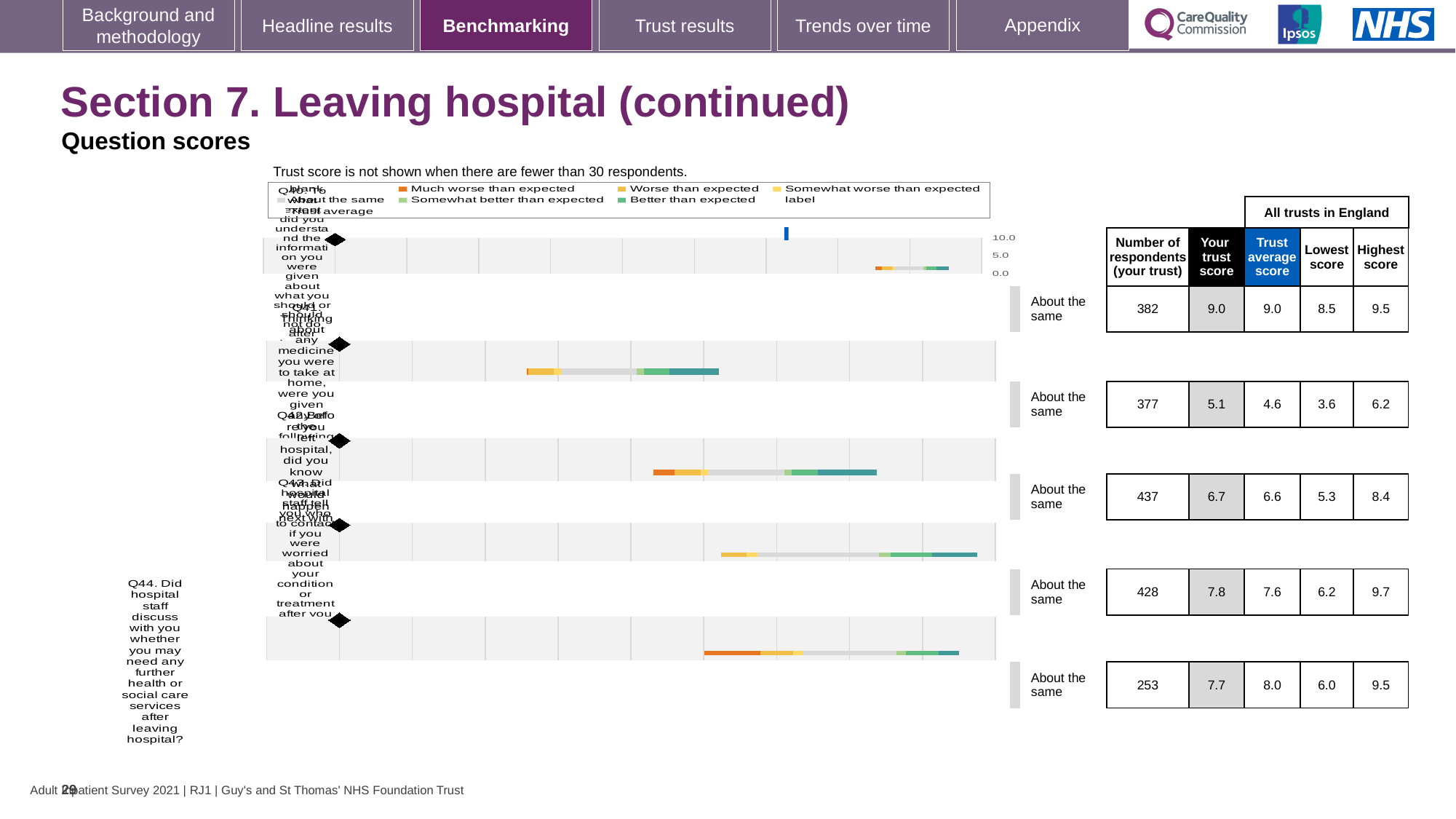
For Q44 (further health or social care services after leaving hospital), how many respondents does the table show for your trust? 253 What kind of chart is used to show the benchmarking results? Bar chart What is the trust average score for Q44 in the table? 8.0 What benchmark category label is shown next to every question row? About the same What is the lowest 'Your trust score' shown in the table? 5.1 How many question rows are shown in the benchmarking chart and table? 5 Which row of the table has the largest number of respondents? 437 (third question row) For Q44, which is larger: your trust score or the trust average score? Trust average score (8.0) For Q44, what is the difference between the highest score and the lowest score across all trusts in England? 3.5 What is the 'Your trust score' for Q44 in the table? 7.7 What is the lowest score across all trusts in England for the first question row (382 respondents)? 8.5 What is the highest score across all trusts in England for Q44? 9.5